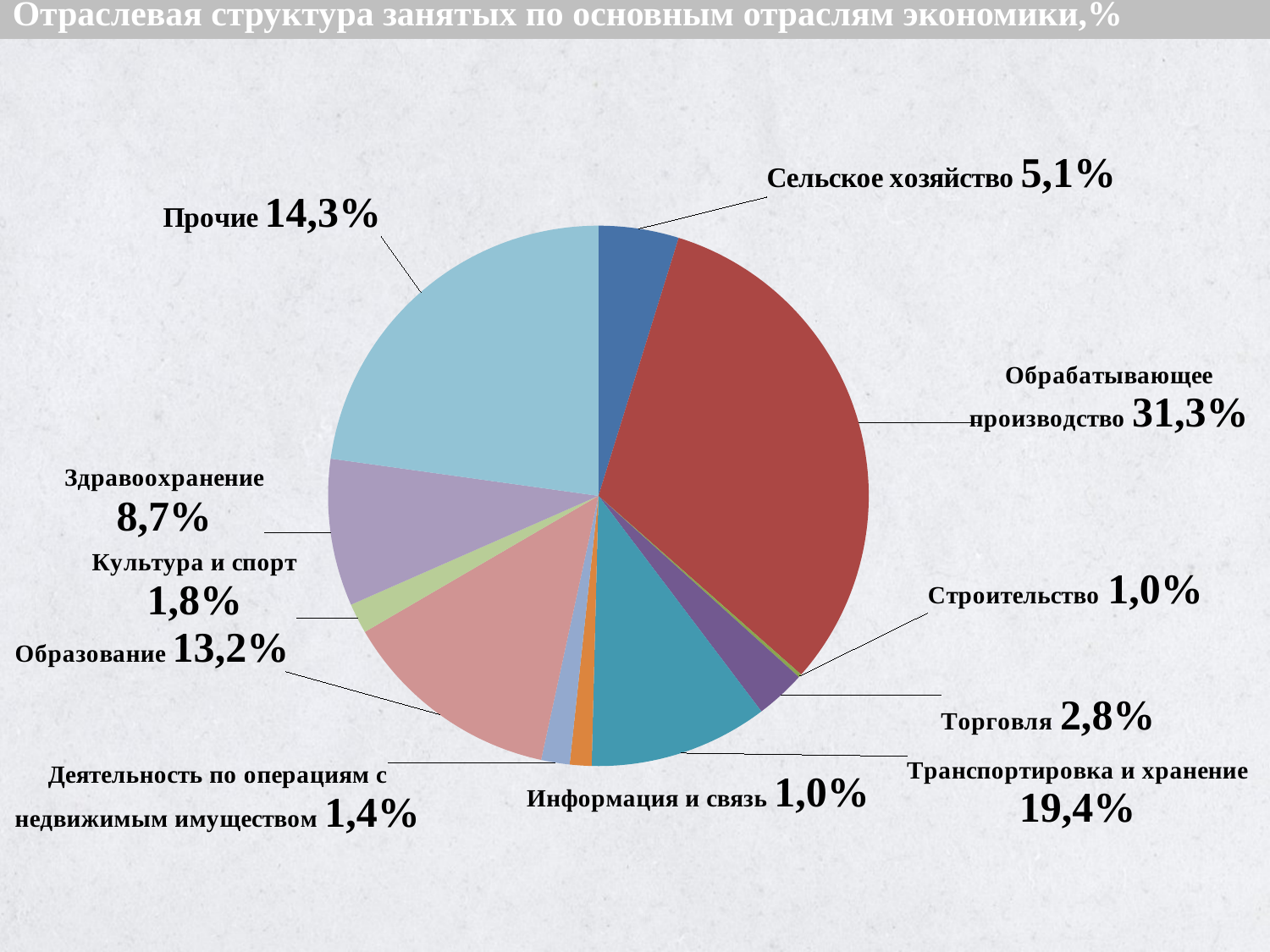
What kind of chart is shown on the slide? pie chart What is the value for Деятельность по операциям с недвижимым имуществом? 1,4% What colour is the slice for Обрабатывающее производство? red Which sector has the largest share of employed? Обрабатывающее производство What is the difference between the shares of Обрабатывающее производство and Транспортировка и хранение? 11,9% What is the difference between the shares of Здравоохранение and Сельское хозяйство? 3,6% What share is shown for Транспортировка и хранение? 19,4% What is the title of the chart? Отраслевая структура занятых по основным отраслям экономики,% What is the value for Здравоохранение? 8,7% Which is larger, the share for Прочие or for Образование? Прочие What share of employed is in Обрабатывающее производство? 31,3% How many slices does the pie chart have? 11